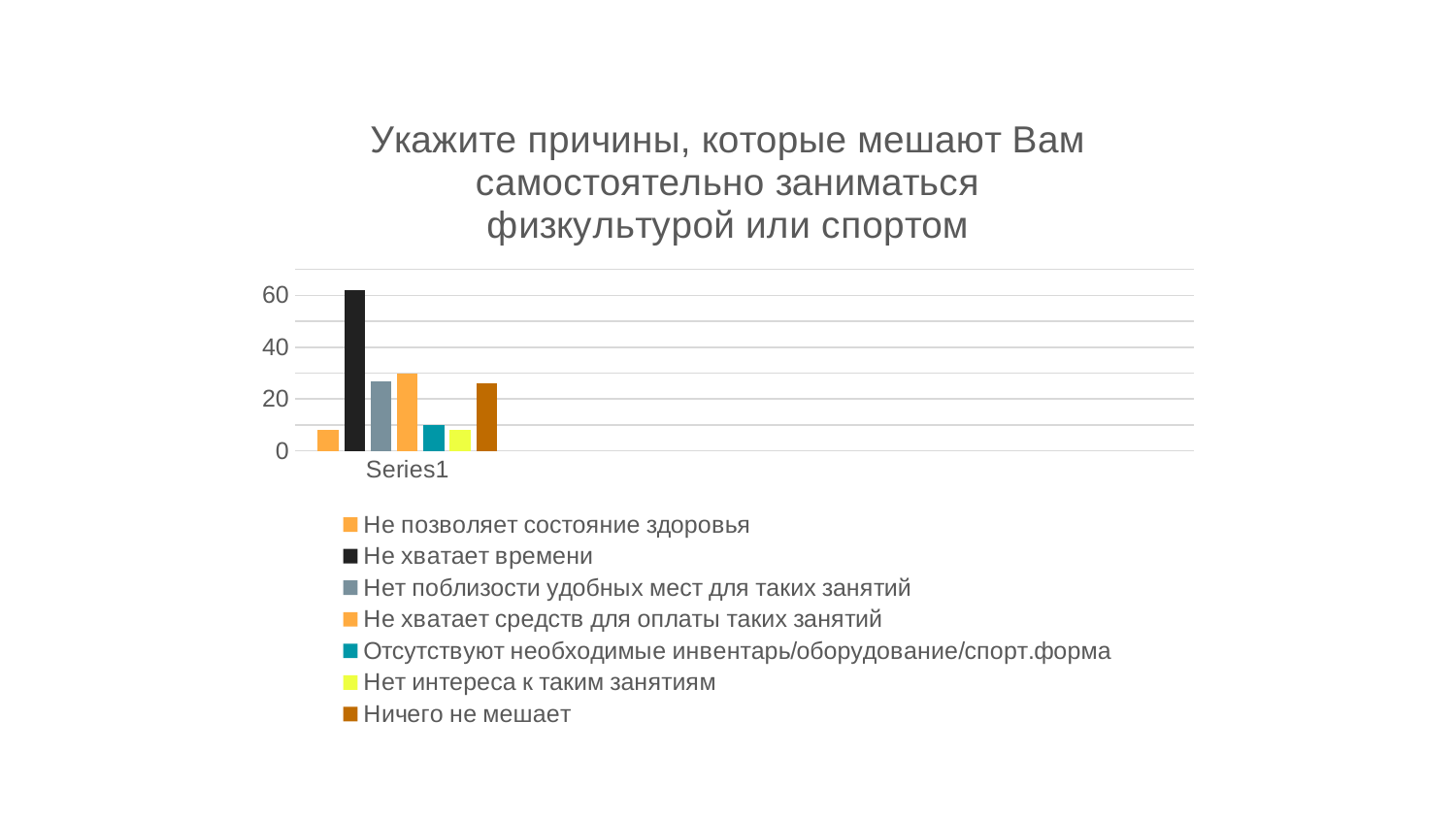
Is the value for "Отсутствуют необходимые инвентарь/оборудование/спорт.форма" greater or less than 20? less Which series has the highest bar? Не хватает времени What kind of chart is shown on the slide? bar chart Which legend entry is shown in black? Не хватает времени Is the value for "Не хватает времени" greater or less than 40? greater Is the value for "Не хватает средств для оплаты таких занятий" greater or less than 20? greater Which is larger: the value for "Не хватает средств для оплаты таких занятий" or the value for "Отсутствуют необходимые инвентарь/оборудование/спорт.форма"? Не хватает средств для оплаты таких занятий How many series does the legend list? 7 What is the title of the chart? Укажите причины, которые мешают Вам самостоятельно заниматься физкультурой или спортом Which is larger: the value for "Не хватает времени" or the value for "Не хватает средств для оплаты таких занятий"? Не хватает времени